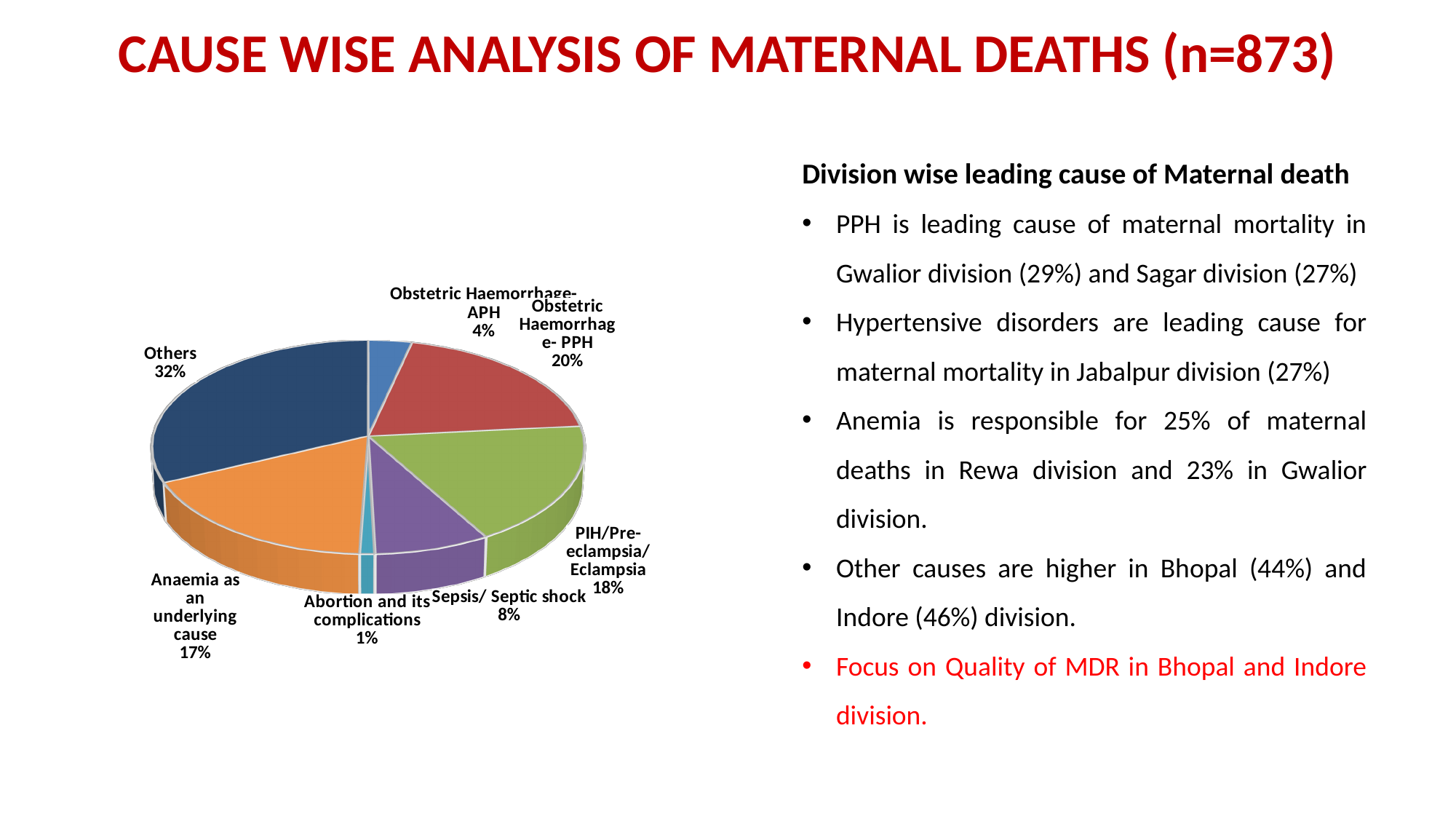
What percentage is shown for PIH/Pre-eclampsia/Eclampsia? 18% What is the title of the slide containing the pie chart? CAUSE WISE ANALYSIS OF MATERNAL DEATHS (n=873) What is the combined share of Obstetric Haemorrhage-APH and Obstetric Haemorrhage-PPH? 24% What share of maternal deaths is attributed to Obstetric Haemorrhage-PPH? 20% What kind of chart is shown on the slide? Pie chart How many slices does the pie chart have? 7 Which cause has the smallest slice of the pie? Abortion and its complications What percentage of maternal deaths is due to Anaemia as an underlying cause? 17% Which cause has the largest slice of the pie? Others What is the difference in percentage points between Others and Obstetric Haemorrhage-PPH? 12 What share of the pie is Sepsis/Septic shock? 8% Which is larger, the share for Obstetric Haemorrhage-APH or the share for Sepsis/Septic shock? Sepsis/Septic shock